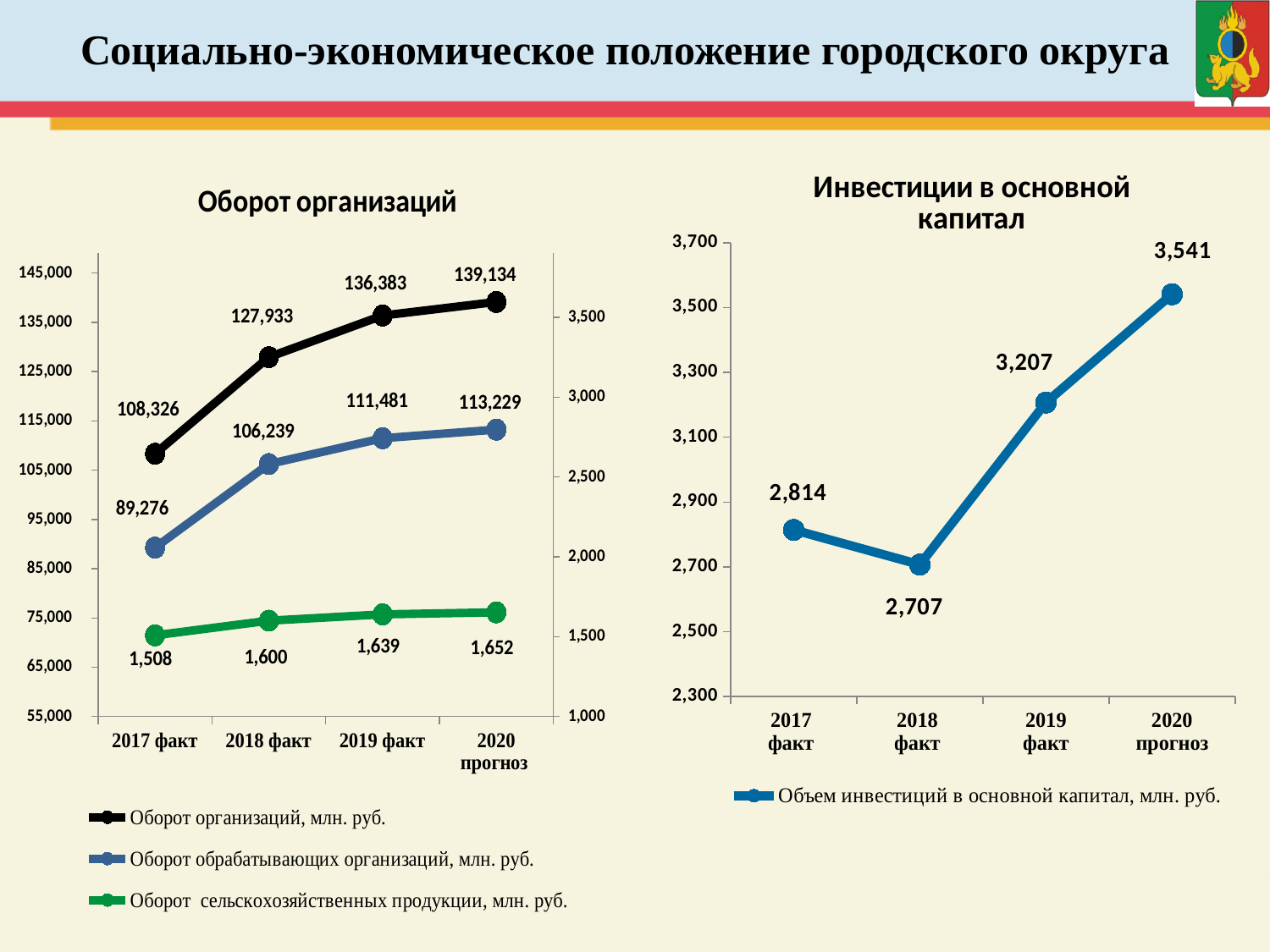
In the chart titled "Инвестиции в основной капитал", what is the difference between the values for 2020 прогноз and 2019 факт? 334 In the chart titled "Оборот организаций", by how much does "Оборот организаций, млн. руб." in 2020 прогноз exceed its value in 2017 факт? 30,808 In the chart titled "Оборот организаций", what is the value of "Оборот организаций, млн. руб." for 2019 факт? 136,383 How many series does the legend of the chart titled "Оборот организаций" list? 3 In the chart titled "Инвестиции в основной капитал", what is the value for 2018 факт? 2,707 In the chart titled "Оборот организаций", does "Оборот обрабатывающих организаций, млн. руб." rise or fall from 2017 факт to 2020 прогноз? rise In the chart titled "Инвестиции в основной капитал", which year has the lowest value? 2018 факт How many data points are plotted in the chart titled "Инвестиции в основной капитал"? 4 What kind of chart is the chart titled "Инвестиции в основной капитал"? line chart In the chart titled "Инвестиции в основной капитал", which year has the highest value? 2020 прогноз In the chart titled "Оборот организаций", what is the value of "Оборот обрабатывающих организаций, млн. руб." for 2017 факт? 89,276 In the chart titled "Оборот организаций", what is the value of "Оборот сельскохозяйственных продукции, млн. руб." for 2020 прогноз? 1,652